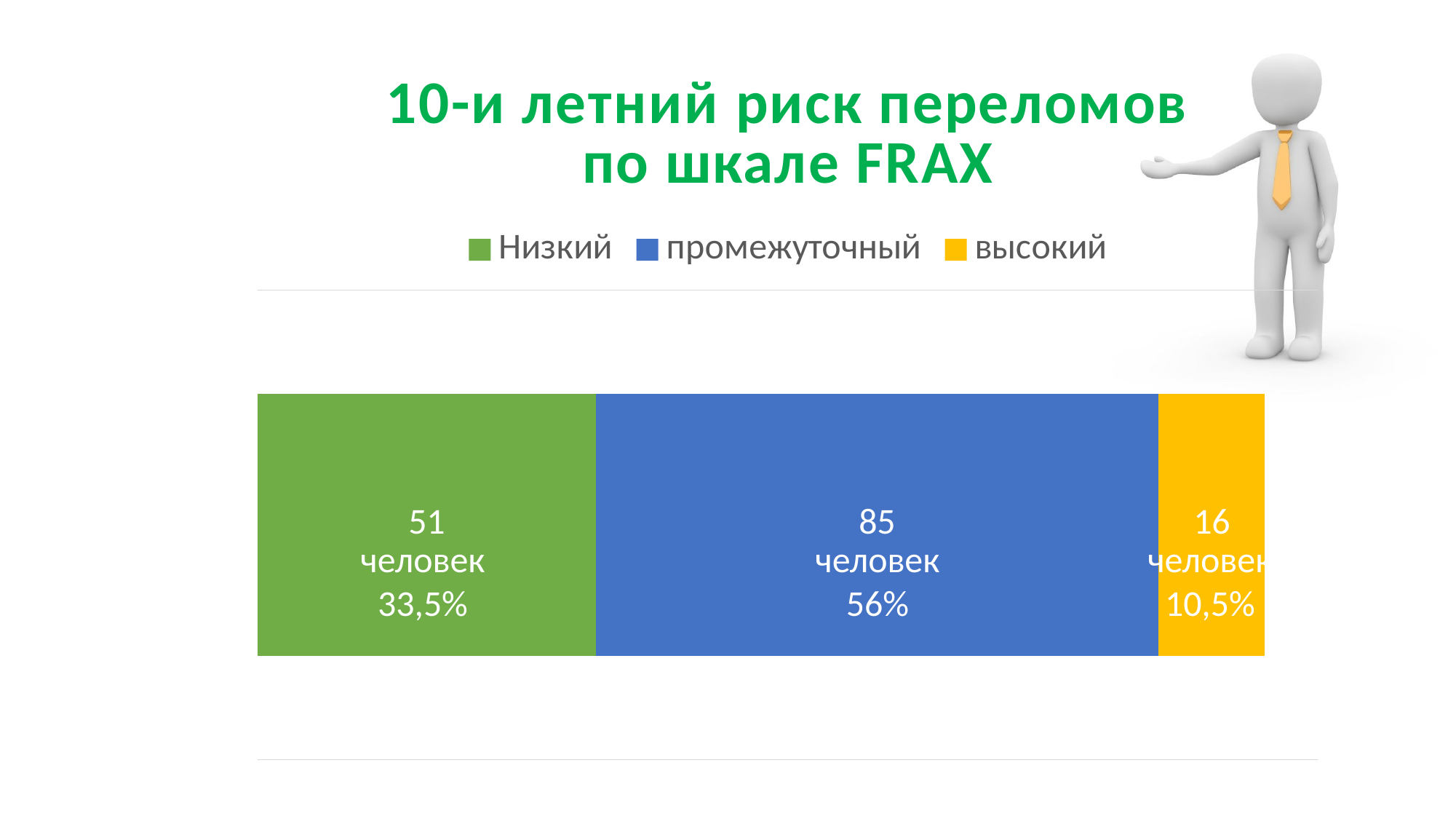
What type of chart is shown on the slide? Stacked bar chart What percentage is shown for the "высокий" (high) risk group? 10,5% How many people are in the "Низкий" (low) risk group? 51 человек What is the title of the chart? 10-и летний риск переломов по шкале FRAX Which risk group has the smallest number of people? высокий How many risk groups (segments) does the stacked bar contain? 3 How many people are in the "высокий" (high) risk group? 16 человек Which risk group has the largest number of people? промежуточный Which group has more people, "Низкий" or "высокий"? Низкий What is the total number of people across all three risk groups in the stacked bar? 152 How many more people are in the "промежуточный" group than in the "Низкий" group? 34 What percentage of people fall into the "промежуточный" (intermediate) risk group? 56%